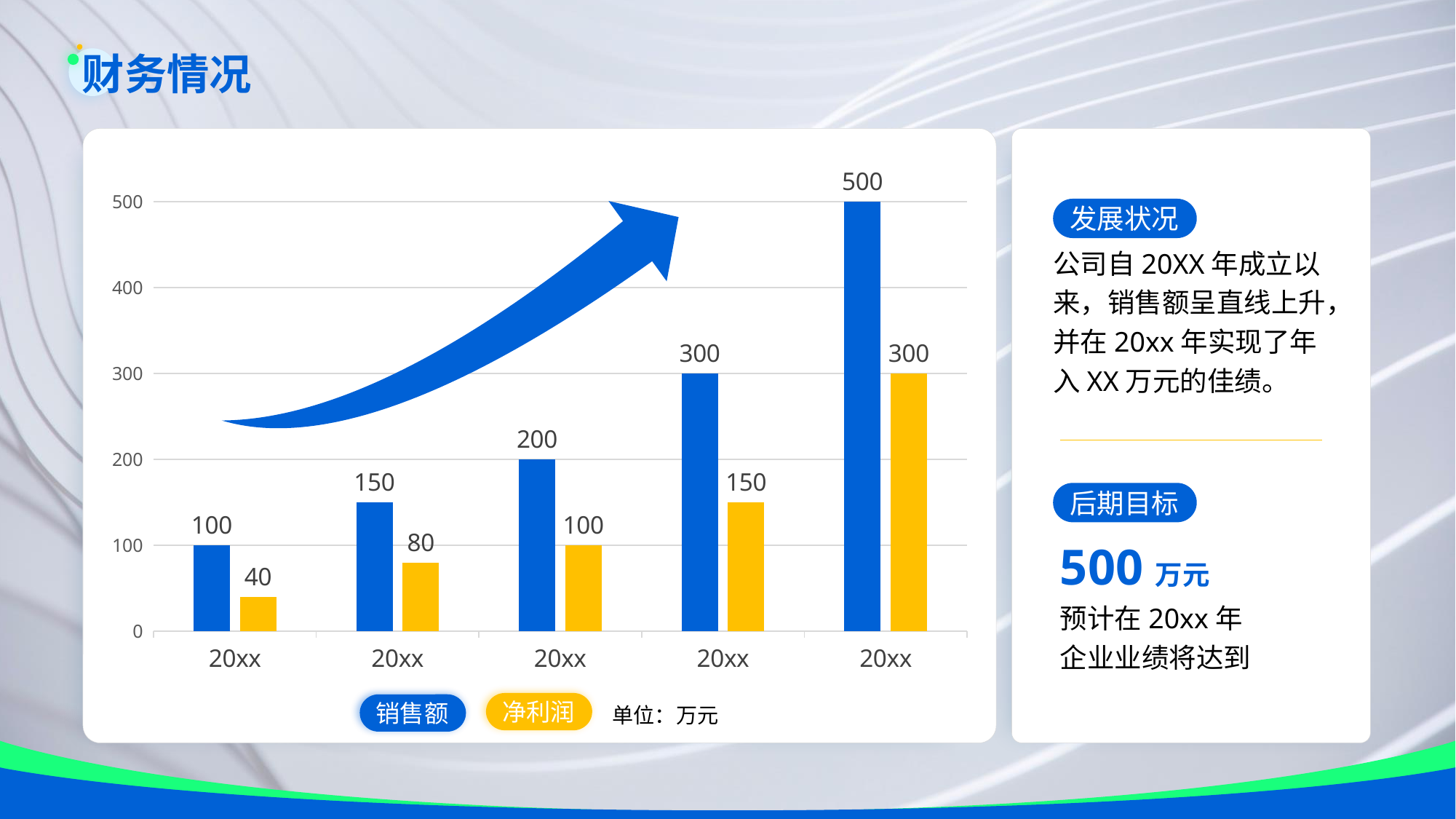
Do the 销售额 values rise or fall from left to right along the x axis? rise What unit is stated below the chart legend? 万元 How many groups of bars are plotted along the x axis? 5 What type of chart is shown on the slide? bar chart How many series does the legend list? 2 What is the 销售额 value for the rightmost (fifth) group of bars? 500 What is the difference between 销售额 and 净利润 in the fourth group of bars from the left? 150 What is the 净利润 value for the leftmost (first) group of bars? 40 Which group of bars has the highest 销售额 value? the rightmost (fifth) group What is the 净利润 value for the third group of bars from the left? 100 Which group of bars has the lowest 净利润 value? the leftmost (first) group In the second group of bars from the left, which is larger, 销售额 or 净利润? 销售额